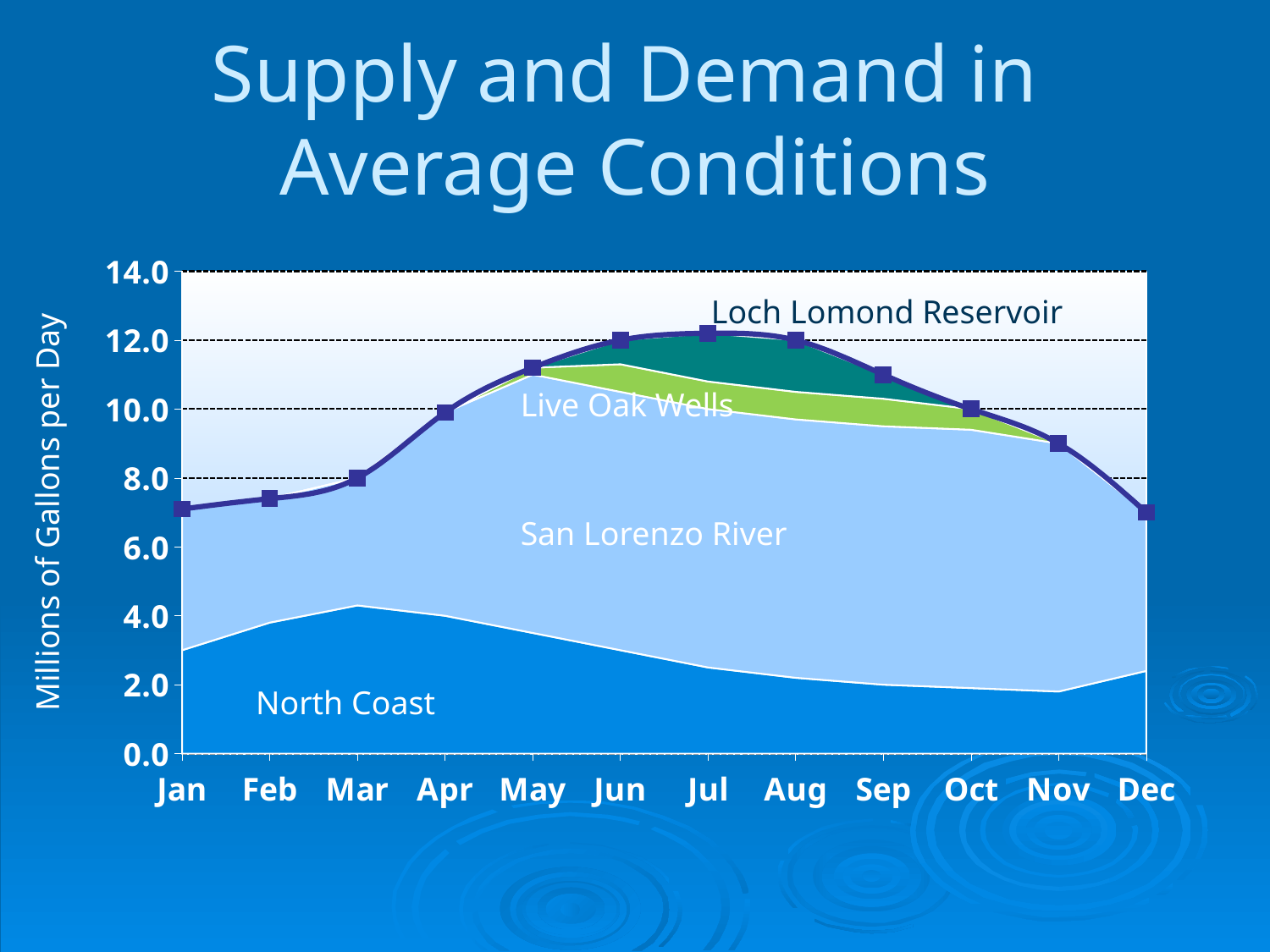
How many supply sources are labelled as areas in the chart? 4 What kind of chart is shown on the slide? Combination area and line chart How many months are shown along the x axis? 12 Is the demand value for Nov greater or less than 8.0? greater Which month has the larger demand value, Mar or Sep? Sep Is the demand value for Sep greater or less than 10.0? greater In which month does the demand line reach its highest value? Jul What is the label on the y axis? Millions of Gallons per Day Is the demand value for Jan greater or less than 8.0? less Does the demand line rise or fall from Jan to Jul? rise